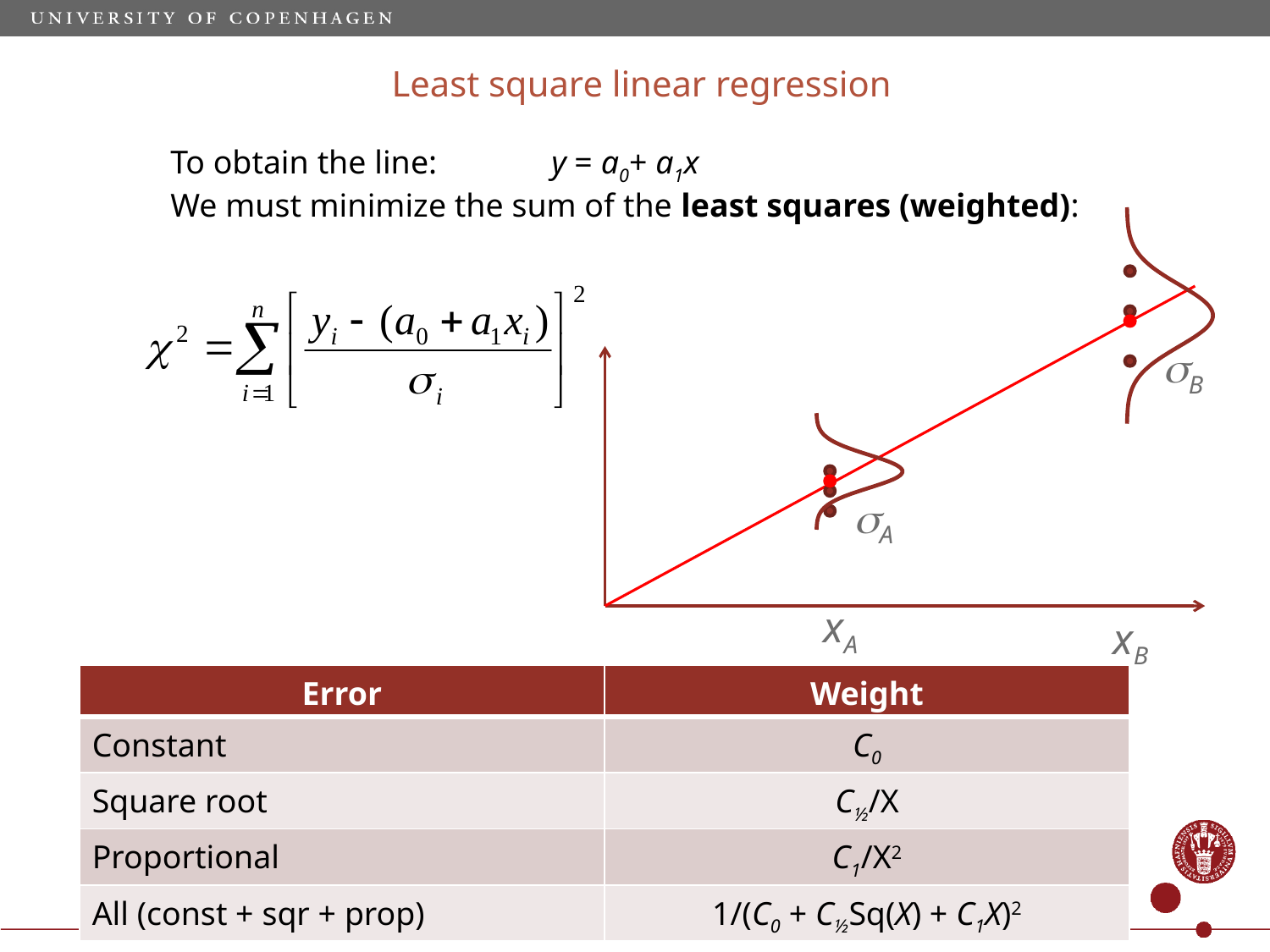
How many labelled x positions are marked on the diagram's x axis? 2 Does the red line in the diagram rise or fall as x increases? rise Which of the two labelled x positions, X_A or X_B, has the higher value on the red line? X_B What label is written next to the distribution curve at the left-hand point of the diagram? σ_A What label is written next to the distribution curve at the right-hand point of the diagram? σ_B